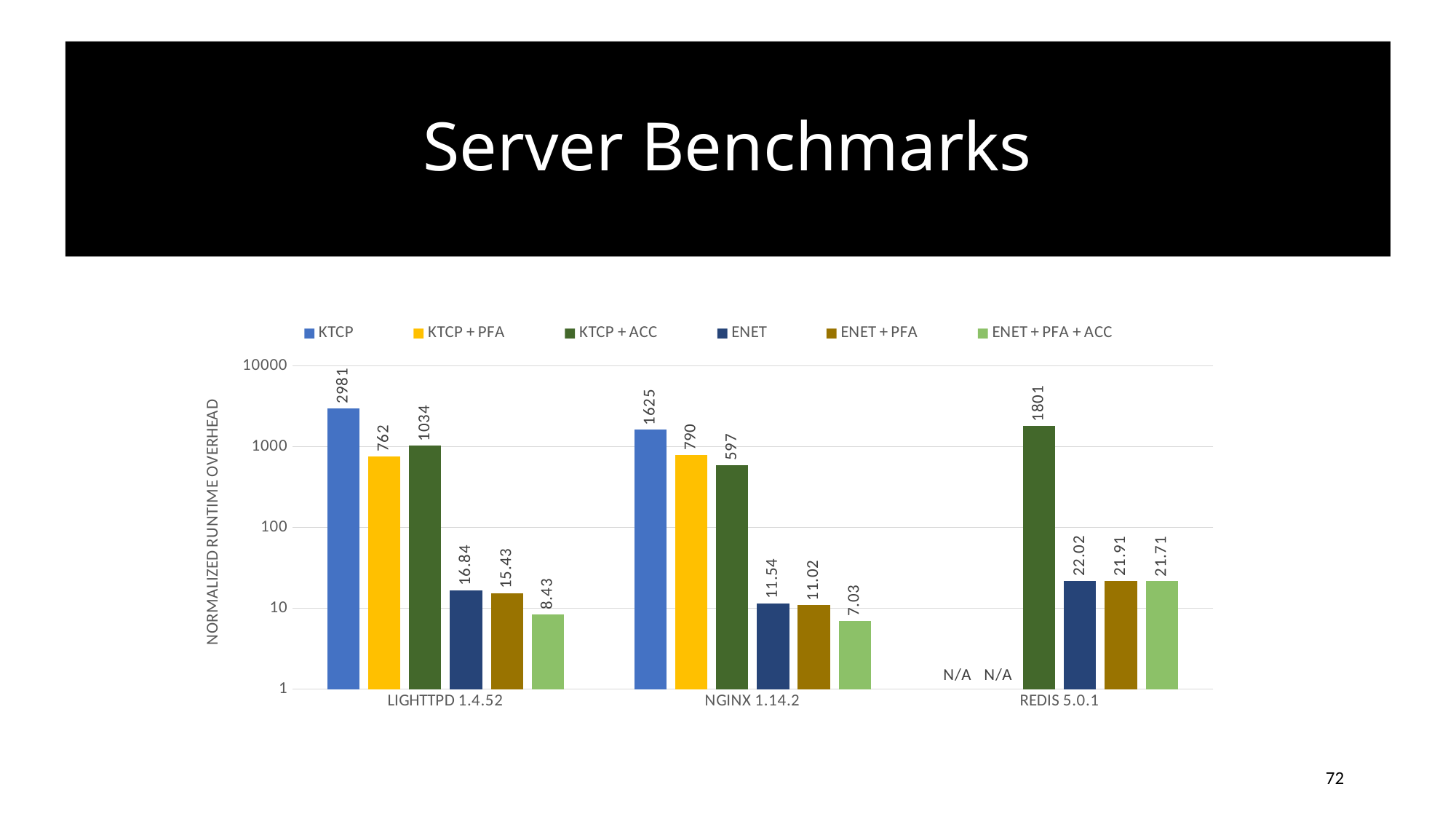
What kind of chart is shown on the slide? bar chart What is the KTCP + ACC value for REDIS 5.0.1? 1801 What is the ENET + PFA + ACC value for NGINX 1.14.2? 7.03 What is the label on the vertical axis? NORMALIZED RUNTIME OVERHEAD Which category has the lowest ENET + PFA + ACC value? NGINX 1.14.2 Which is larger for LIGHTTPD 1.4.52: KTCP + PFA or KTCP + ACC? KTCP + ACC How many categories are shown on the x axis? 3 Which category has the highest KTCP value? LIGHTTPD 1.4.52 What is the KTCP value for LIGHTTPD 1.4.52? 2981 What is the ENET value for REDIS 5.0.1? 22.02 What is the difference between the KTCP values for LIGHTTPD 1.4.52 and NGINX 1.14.2? 1356 How many series does the legend list? 6